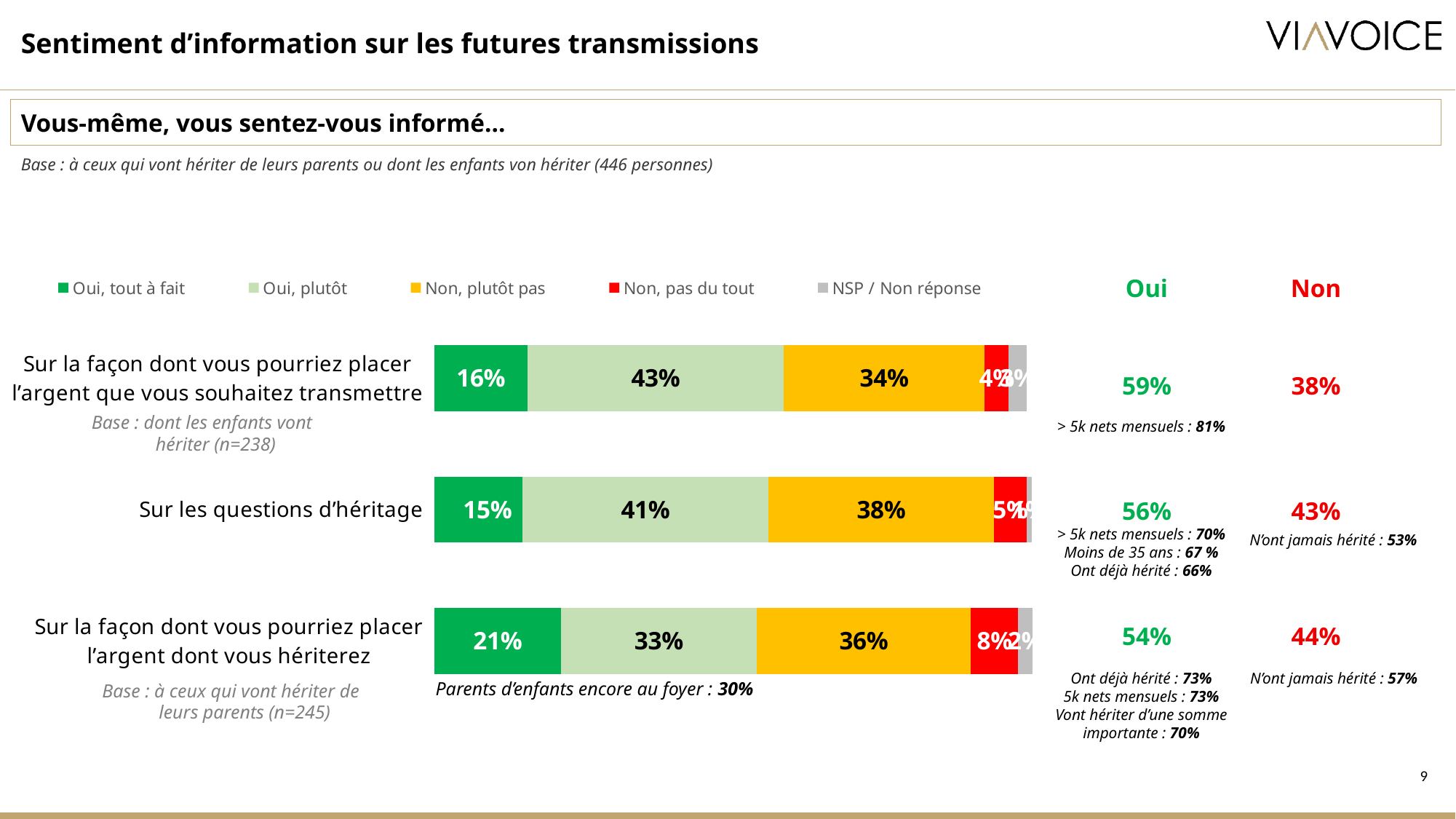
Which is larger: the "Oui, plutôt" value for "Sur les questions d'héritage" or for "Sur la façon dont vous pourriez placer l'argent dont vous hériterez"? Sur les questions d'héritage What is the total "Oui" share shown for "Sur la façon dont vous pourriez placer l'argent que vous souhaitez transmettre"? 59% Which category has the lowest "Oui, plutôt" value? Sur la façon dont vous pourriez placer l'argent dont vous hériterez What is the value of "Non, plutôt pas" for "Sur la façon dont vous pourriez placer l'argent dont vous hériterez"? 36% What is the value of "Oui, tout à fait" for "Sur les questions d'héritage"? 15% What is the difference between the "Non, plutôt pas" values for "Sur les questions d'héritage" and "Sur la façon dont vous pourriez placer l'argent que vous souhaitez transmettre"? 4 percentage points What is the value of "Oui, plutôt" for "Sur la façon dont vous pourriez placer l'argent que vous souhaitez transmettre"? 43% How many series does the legend list? 5 Which category has the highest "Oui, tout à fait" value? Sur la façon dont vous pourriez placer l'argent dont vous hériterez What kind of chart is shown on the slide? Stacked bar chart What is the value of "Non, pas du tout" for "Sur la façon dont vous pourriez placer l'argent dont vous hériterez"? 8% How many categories (questions) are plotted in the chart? 3